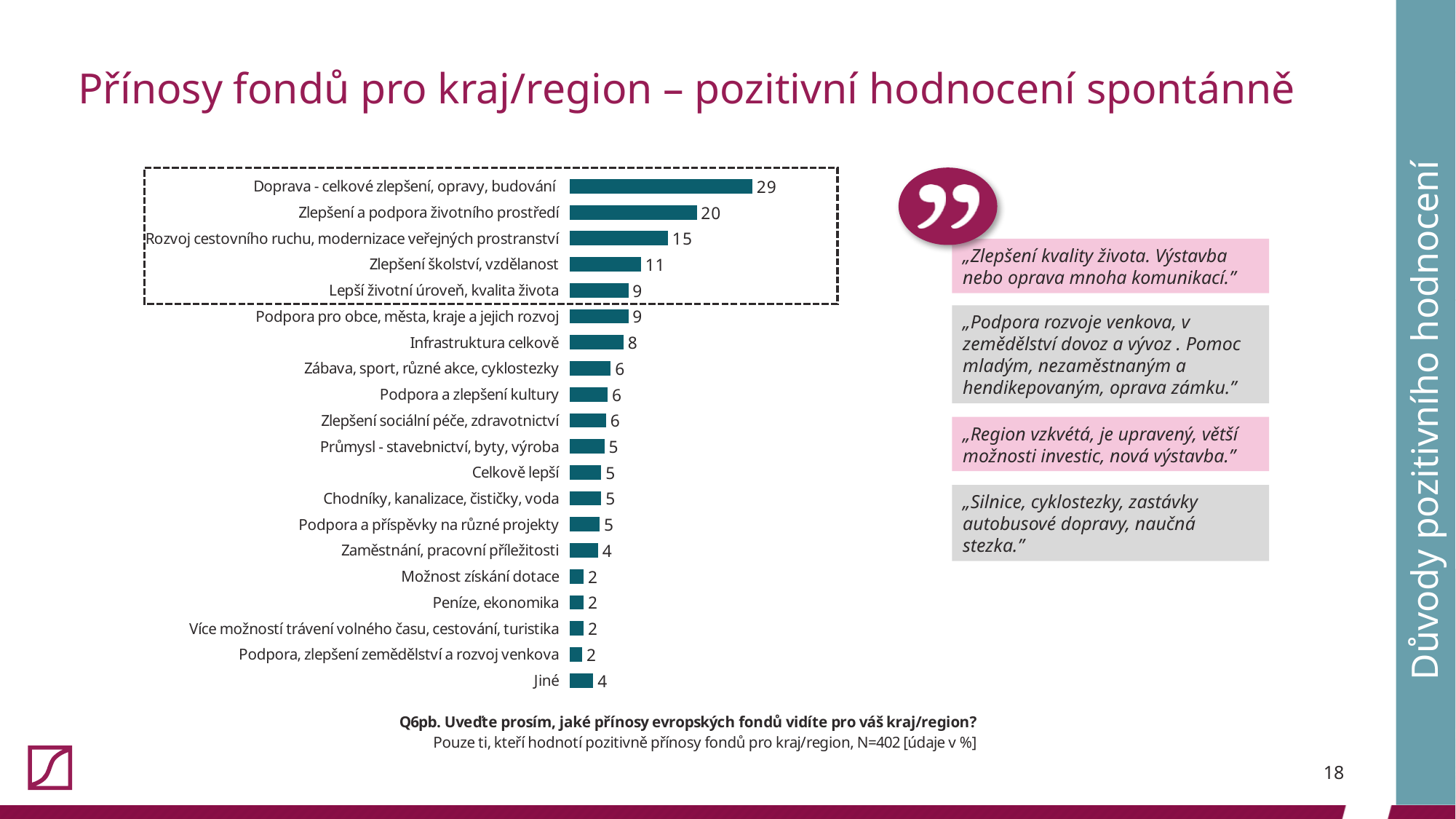
What value is shown for "Zlepšení školství, vzdělanost"? 11 What value is shown for "Jiné"? 4 What is the sample size (N) stated below the chart? N=402 Which category has the highest value in the chart? Doprava - celkové zlepšení, opravy, budování How many categories are plotted in the chart? 20 Which is larger: the value for "Zlepšení a podpora životního prostředí" or the value for "Rozvoj cestovního ruchu, modernizace veřejných prostranství"? Zlepšení a podpora životního prostředí What is the difference between the values for "Doprava - celkové zlepšení, opravy, budování" and "Zlepšení a podpora životního prostředí"? 9 What is the difference between the values for "Rozvoj cestovního ruchu, modernizace veřejných prostranství" and "Zlepšení školství, vzdělanost"? 4 What value is shown for "Infrastruktura celkově"? 8 What kind of chart is shown on the slide? Bar chart What value is shown for "Doprava - celkové zlepšení, opravy, budování"? 29 Which is larger: the value for "Zaměstnání, pracovní příležitosti" or the value for "Peníze, ekonomika"? Zaměstnání, pracovní příležitosti